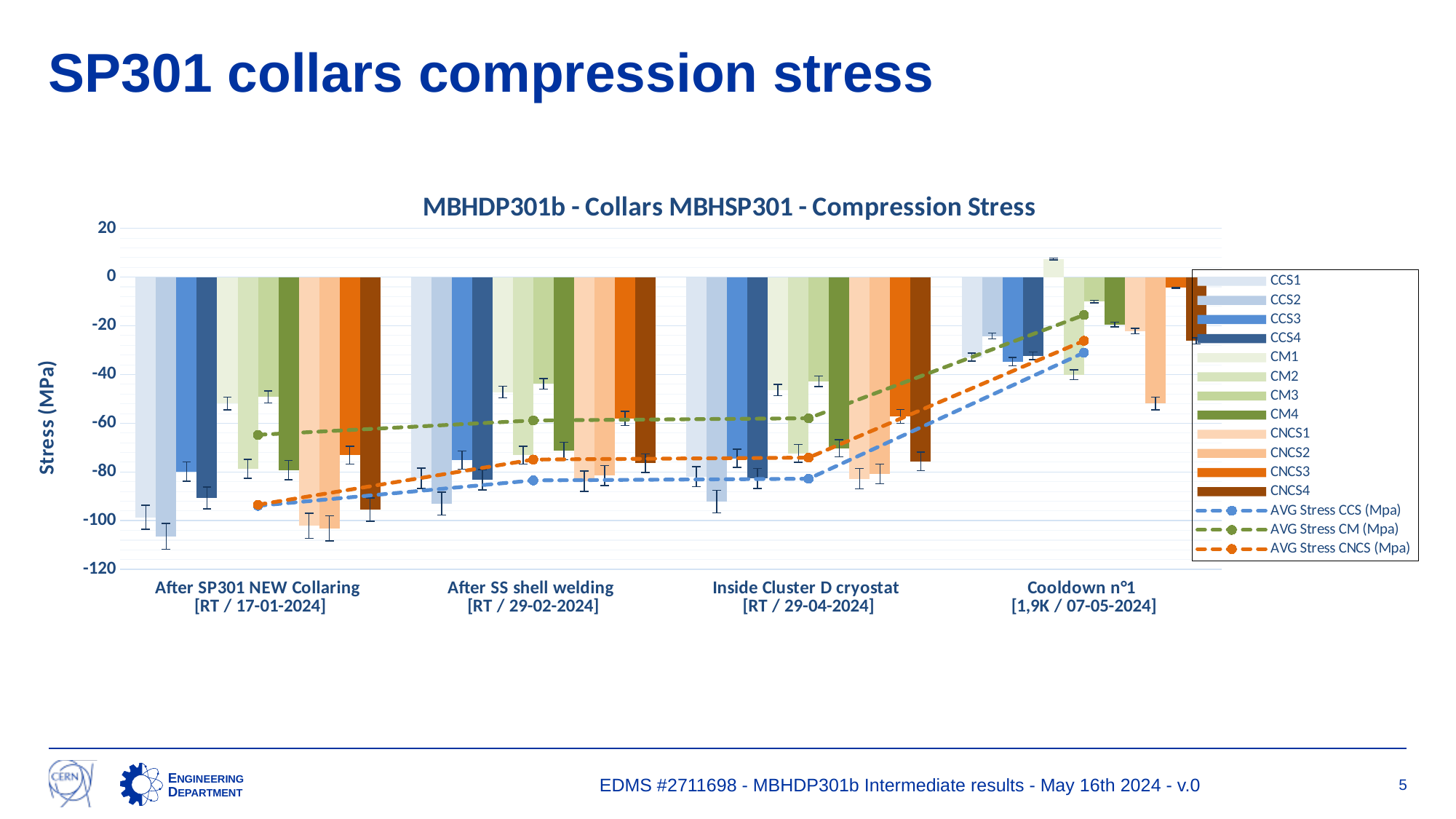
Which of the three average stress lines is highest at 'Cooldown n°1'? AVG Stress CM (Mpa) Is the value for CCS2 at 'After SP301 NEW Collaring' greater or less than -100? less How many entries does the chart's legend list? 15 At 'After SP301 NEW Collaring', which is higher: AVG Stress CM (Mpa) or AVG Stress CCS (Mpa)? AVG Stress CM (Mpa) What is the title of the chart? MBHDP301b - Collars MBHSP301 - Compression Stress Is the value for CNCS2 at 'Cooldown n°1' greater or less than -40? less Is the value for CM1 at 'After SP301 NEW Collaring' greater or less than -60? greater Does the AVG Stress CCS (Mpa) line rise or fall from 'After SP301 NEW Collaring' to 'Cooldown n°1'? rise What kind of chart is shown on the slide? Bar chart with dashed line series What is the label of the chart's vertical axis? Stress (MPa) How many categories are shown along the x axis of the chart? 4